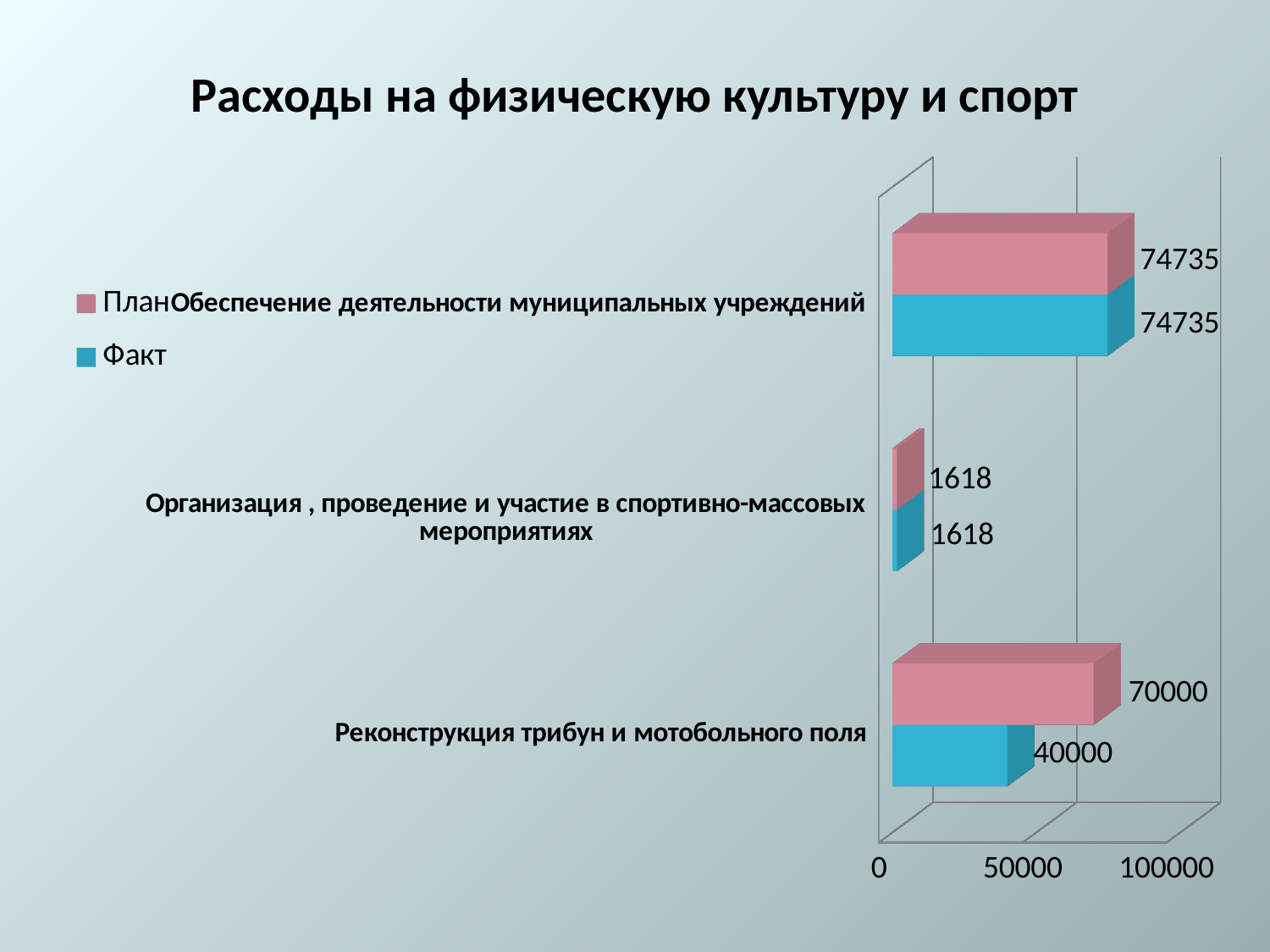
Which category has the highest План value? Обеспечение деятельности муниципальных учреждений Which is larger for Реконструкция трибун и мотобольного поля, the План value or the Факт value? План What is the Факт value for Обеспечение деятельности муниципальных учреждений? 74735 What is the Факт value for Реконструкция трибун и мотобольного поля? 40000 What kind of chart is shown on the slide? Bar chart What is the План value for Организация, проведение и участие в спортивно-массовых мероприятиях? 1618 Which category has the lowest Факт value? Организация , проведение и участие в спортивно-массовых мероприятиях How many categories are shown on the chart? 3 What is the difference between the План and Факт values for Реконструкция трибун и мотобольного поля? 30000 How many series does the legend list? 2 What is the title of the chart? Расходы на физическую культуру и спорт What is the План value for Реконструкция трибун и мотобольного поля? 70000